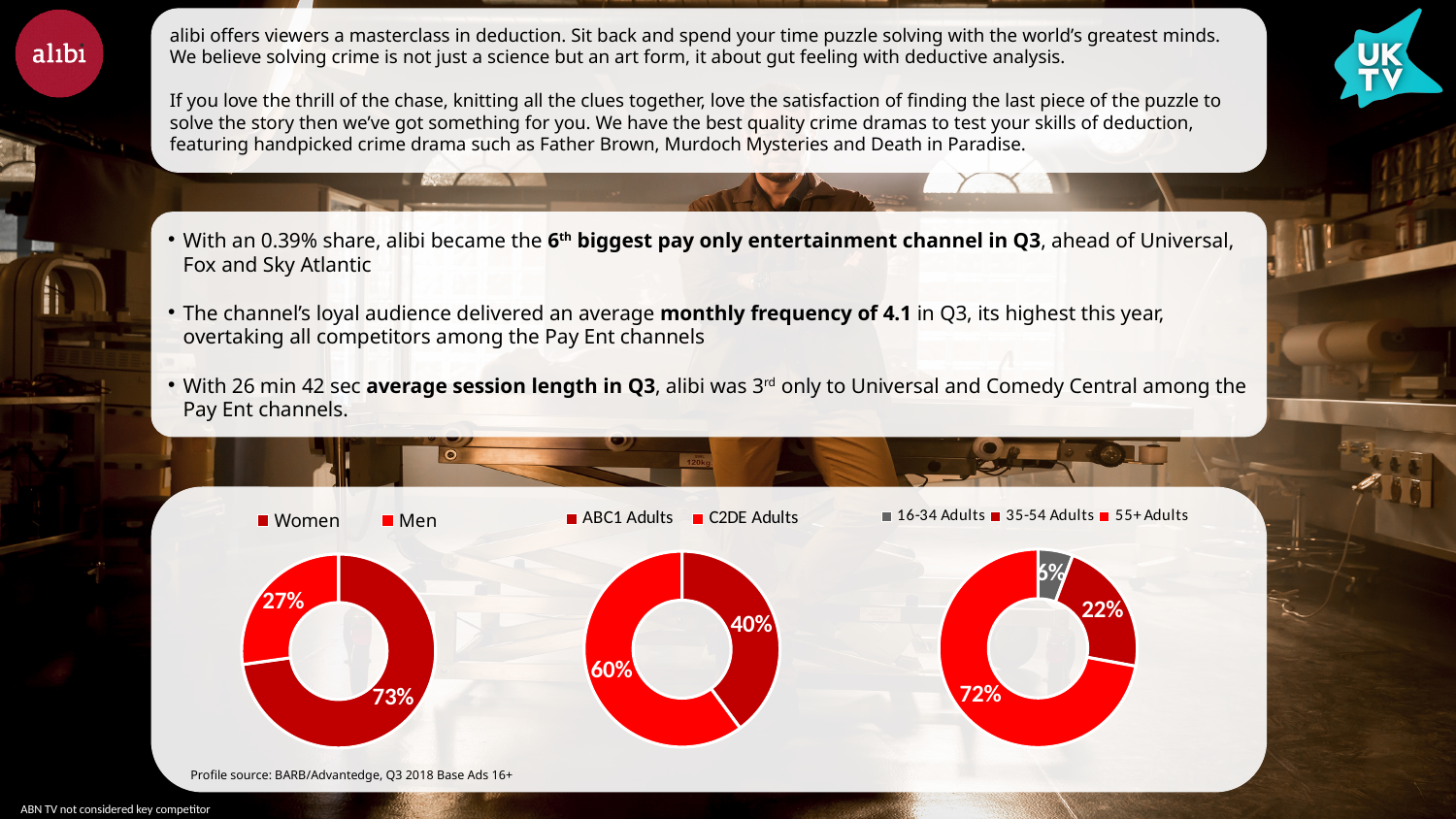
On the middle donut chart, which is larger, ABC1 Adults or C2DE Adults? C2DE Adults On the right donut chart (age groups), what percentage is shown for 55+ Adults? 72% On the right donut chart (age groups), what percentage is shown for 16-34 Adults? 6% On the right donut chart (age groups), which age group has the largest share? 55+ Adults On the middle donut chart (ABC1/C2DE Adults), what percentage is shown for C2DE Adults? 60% On the left donut chart (Women/Men), what is the difference in percentage points between Men and Women? 46 On the left donut chart (Women/Men), what percentage is shown for Men? 27% On the middle donut chart (ABC1/C2DE Adults), what percentage is shown for ABC1 Adults? 40% On the left donut chart (Women/Men), what percentage is shown for Women? 73% What type of chart is used for the three audience profile charts on the slide? Donut (pie) chart On the right donut chart (age groups), which age group has the smallest share? 16-34 Adults How many categories does the legend of the right donut chart (age groups) list? 3